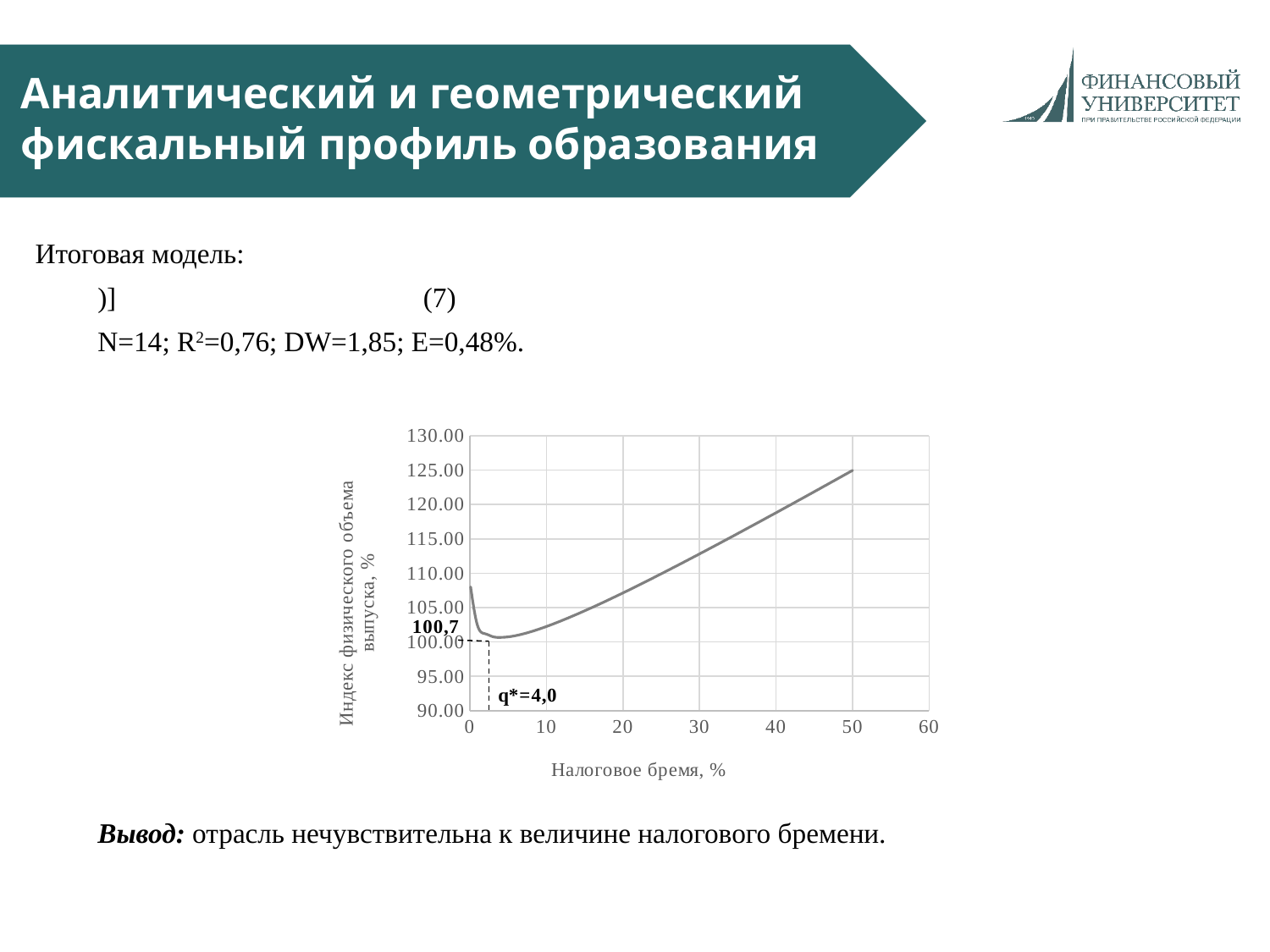
Is the value of the curve at a tax burden of 10 greater or less than 105? less How many lines (series) are plotted on the chart? 1 Is the value of the curve at a tax burden of 20 greater or less than 110? less What is the label of the y axis of the chart? Индекс физического объема выпуска, % What is the minimum value of the output index marked on the chart? 100,7 Which is larger: the value of the curve at a tax burden of 50 or at a tax burden of 0? at 50 What is the label of the x axis of the chart? Налоговое бремя, % At what tax burden (q*) does the curve reach its minimum, according to the label on the chart? q*=4,0 Is the value of the curve at a tax burden of 0 greater or less than 105? greater Does the curve rise or fall as the tax burden increases from 10 to 50? rises What kind of chart is shown on the slide? line chart